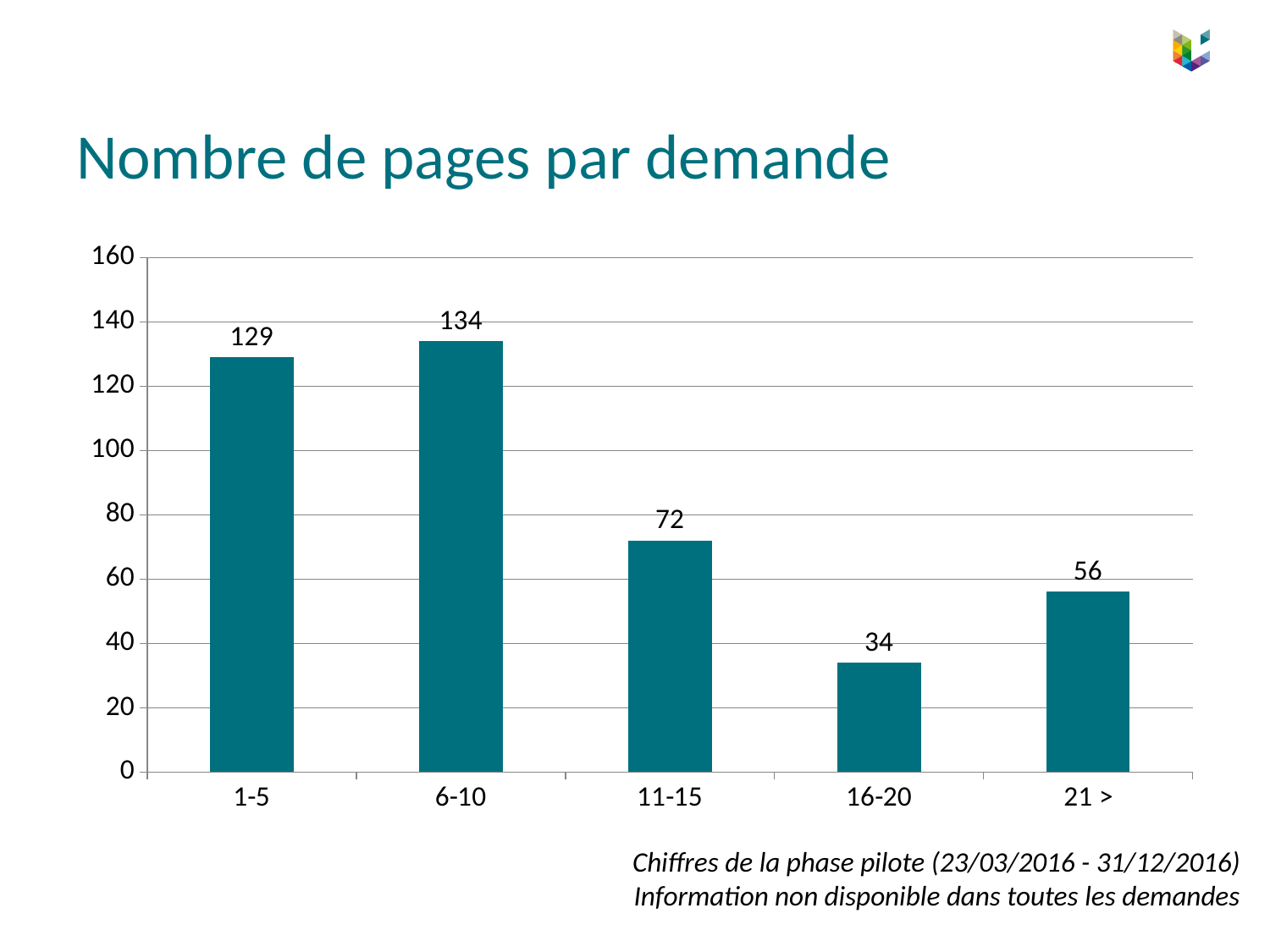
What is the value for the 16-20 category? 34 What is the difference between the values for 11-15 and 16-20? 38 What is the value for the 6-10 category? 134 What is the value for the 1-5 category? 129 What is the value for the 21 > category? 56 What kind of chart is shown on the slide? Bar chart What is the difference between the values for 6-10 and 1-5? 5 Which category has the highest value? 6-10 What is the title of the slide? Nombre de pages par demande How many categories are shown on the x axis? 5 Which is larger, the value for 11-15 or the value for 21 >? 11-15 Which category has the lowest value? 16-20